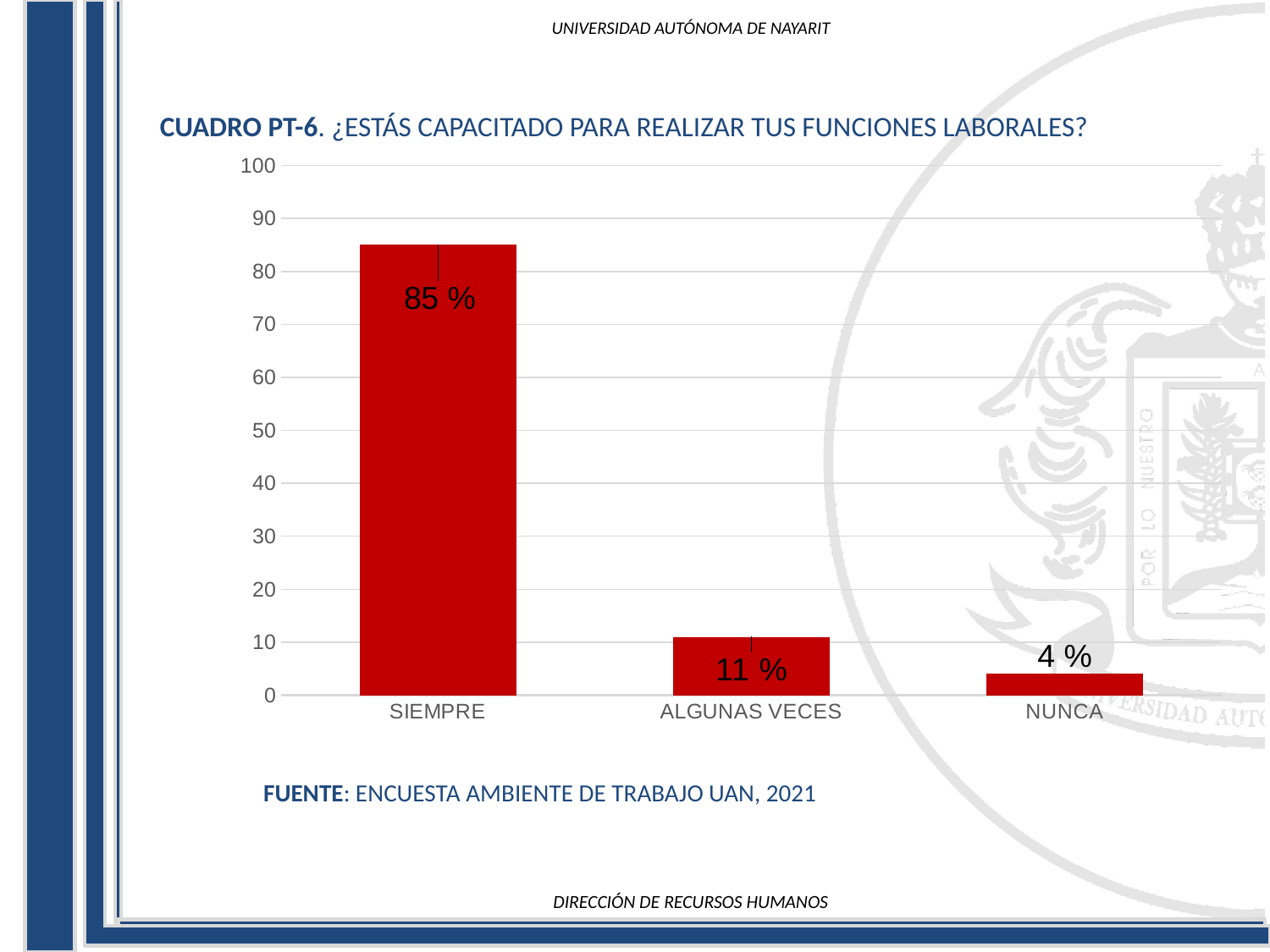
Which category has the lowest value? NUNCA What is the source cited below the chart? ENCUESTA AMBIENTE DE TRABAJO UAN, 2021 What is the value for SIEMPRE? 85 % What is the difference between the values for SIEMPRE and ALGUNAS VECES? 74 % How many categories are shown on the x axis? 3 Which category has the highest value? SIEMPRE Is the value for SIEMPRE greater or less than 80? greater What is the value for NUNCA? 4 % What is the difference between the values for ALGUNAS VECES and NUNCA? 7 % Which is larger, the value for ALGUNAS VECES or the value for NUNCA? ALGUNAS VECES What is the value for ALGUNAS VECES? 11 % What kind of chart is shown on the slide? bar chart